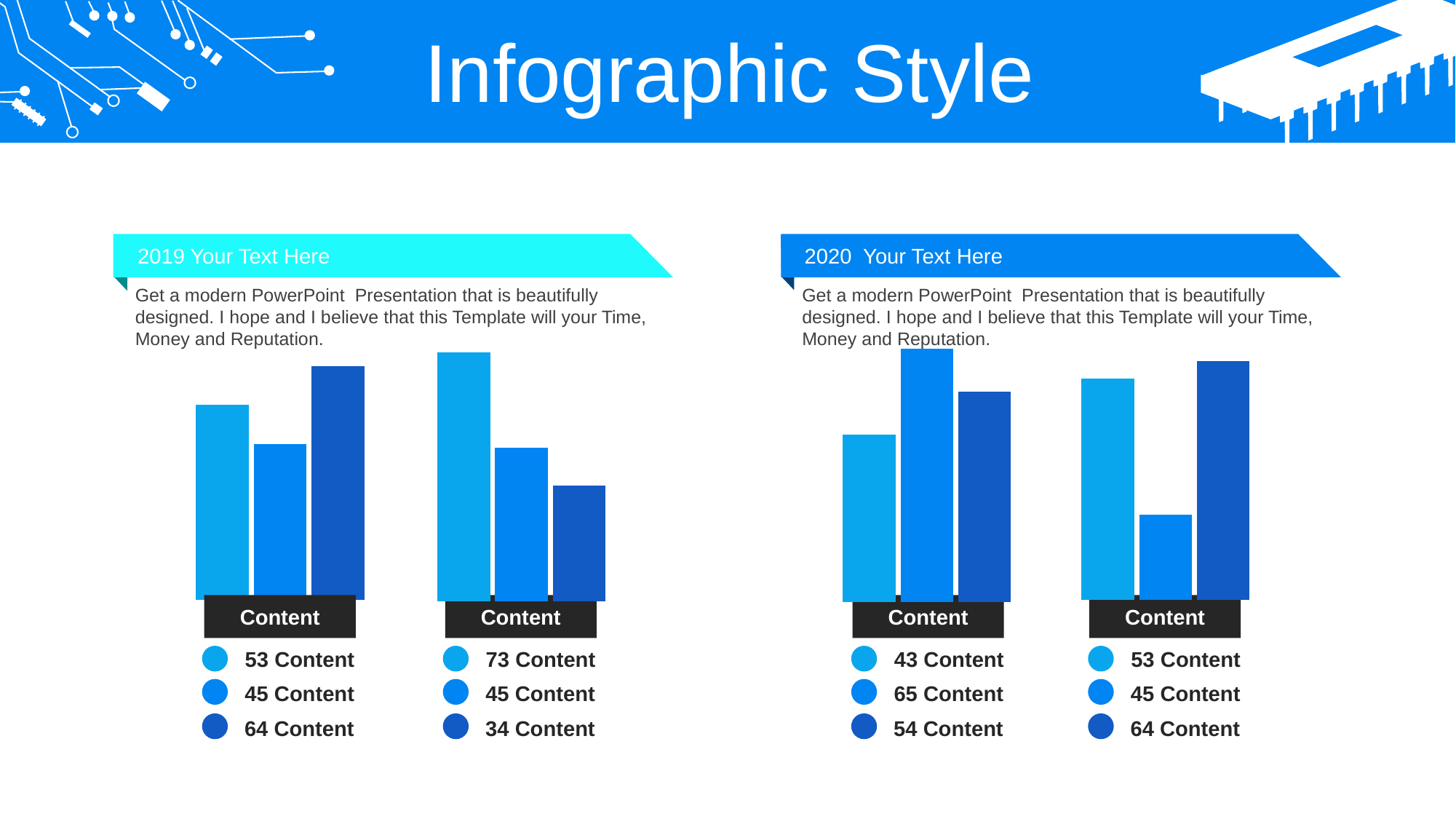
In the 2020 section, left chart, is the medium blue bar (65) larger or smaller than the dark blue bar (54)? larger In the 2019 section, left chart, what is the difference between the dark blue bar value (64) and the medium blue bar value (45)? 19 In the 2020 section, right chart, which bar is the shortest: the light blue, medium blue or dark blue one? medium blue In the 2019 section, right chart, what value does the first (light blue) legend entry show? 73 How many bars does each chart group on the slide contain? 3 In the 2019 section, right chart, what is the difference between the light blue bar value (73) and the dark blue bar value (34)? 39 In the 2019 section, left chart, what value does the first (light blue) legend entry show? 53 What type of chart is used in the 2019 and 2020 sections of the slide? bar chart What is the label shown on the dark box beneath each bar group? Content In the 2019 section, right chart, which bar is the tallest: the light blue, medium blue or dark blue one? light blue In the 2020 section, right chart, what value does the third (dark blue) legend entry show? 64 In the 2020 section, left chart, what value does the second (medium blue) legend entry show? 65